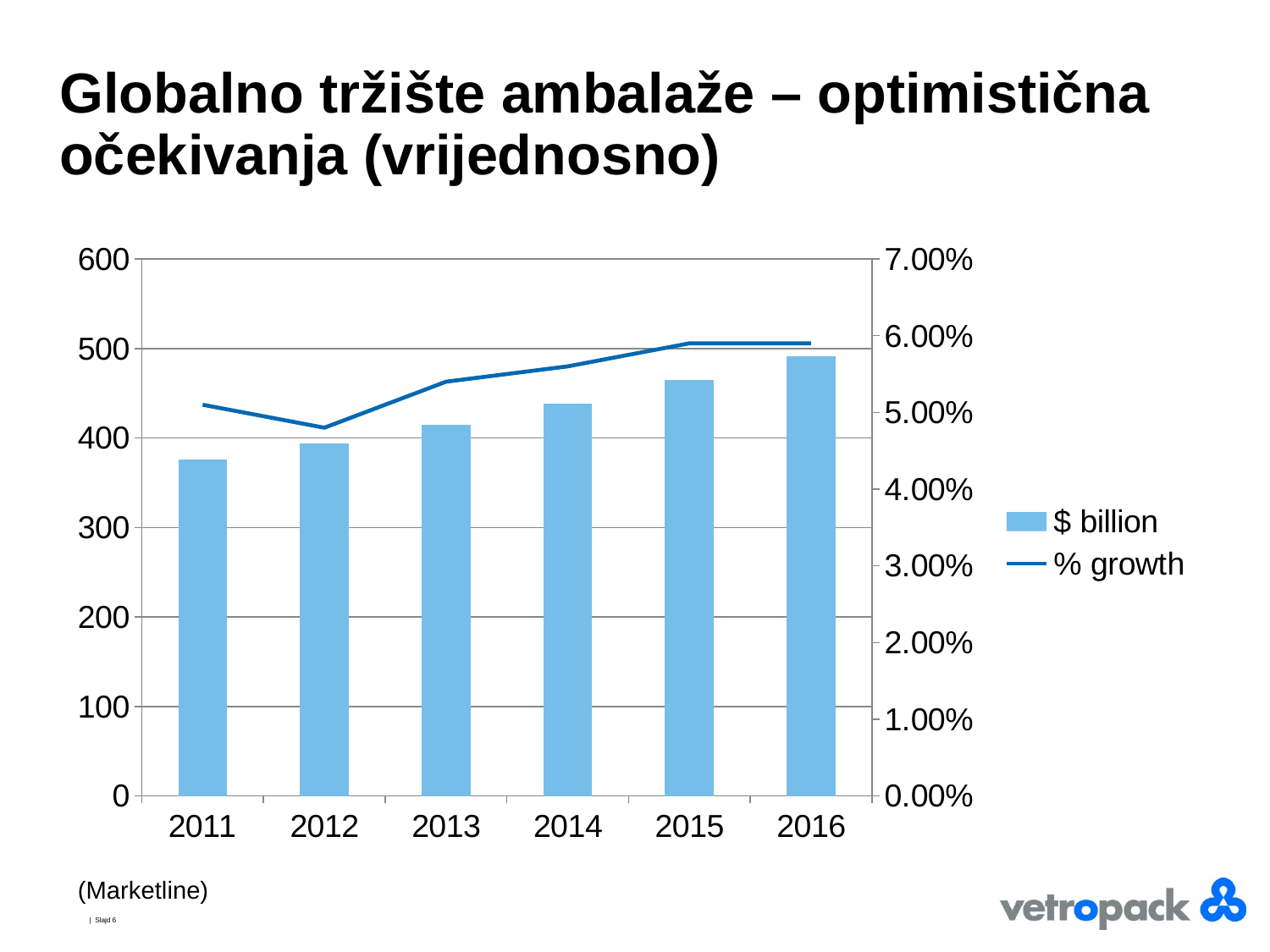
Do the $ billion bars rise or fall from 2011 to 2016? rise How many series does the chart legend list? 2 Which year has the highest $ billion bar? 2016 What kind of chart is shown on the slide? A combined bar and line chart What are the two series named in the chart legend? $ billion and % growth Which year has the lowest $ billion bar? 2011 Is the $ billion value for 2016 greater or less than 500? less Is the $ billion value for 2014 greater or less than 400? greater Which year has the lowest % growth value? 2012 Is the $ billion value for 2011 greater or less than 400? less How many years are shown on the x axis of the chart? 6